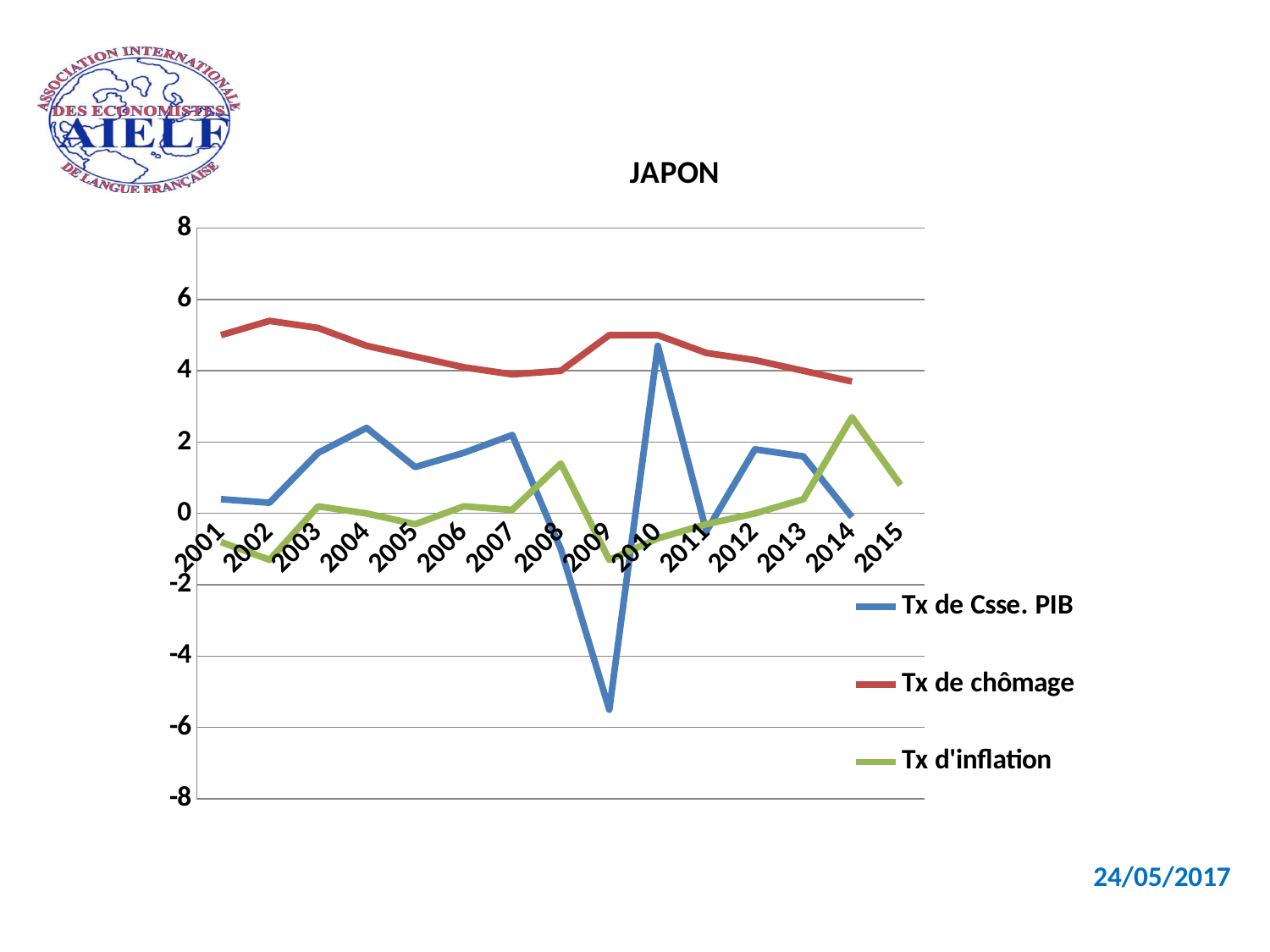
Which series is drawn in red? Tx de chômage Is the value of Tx de Csse. PIB in 2009 greater or less than -4? less In 2009, which is larger: Tx de chômage or Tx de Csse. PIB? Tx de chômage In which year does Tx d'inflation reach its highest value? 2014 How many series does the legend list? 3 Does Tx de chômage rise or fall from 2010 to 2015? fall In which year does Tx de Csse. PIB reach its lowest value? 2009 What is the title of the chart? JAPON Is the value of Tx de chômage in 2002 greater or less than 4? greater How many years are plotted along the x axis? 15 In which year does Tx de Csse. PIB reach its highest value? 2010 What kind of chart is shown on the slide? line chart